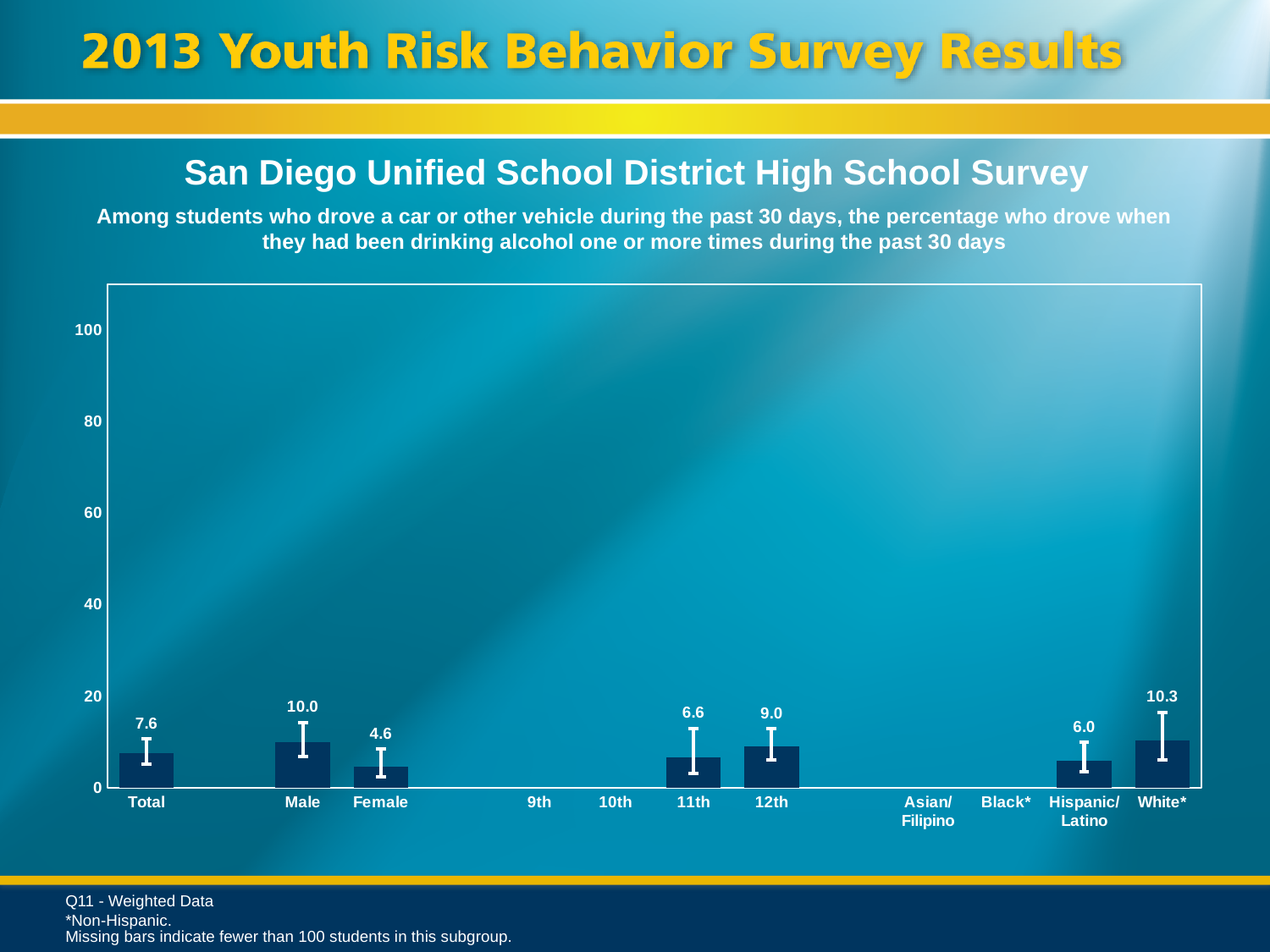
Is the value for Hispanic/Latino greater or less than 20? less Which category has the highest value? White* Which is larger, the value for 11th or the value for 12th? 12th What is the value for Total? 7.6 Which categories on the x axis have no bar shown? 9th, 10th, Asian/Filipino, Black* What is the value for Male? 10.0 What kind of chart is shown on the slide? bar chart What is the value for 12th? 9.0 What is the difference between the values for Male and Female? 5.4 Which category has the lowest plotted value? Female How many bars are plotted on the chart? 7 What is the value for Female? 4.6